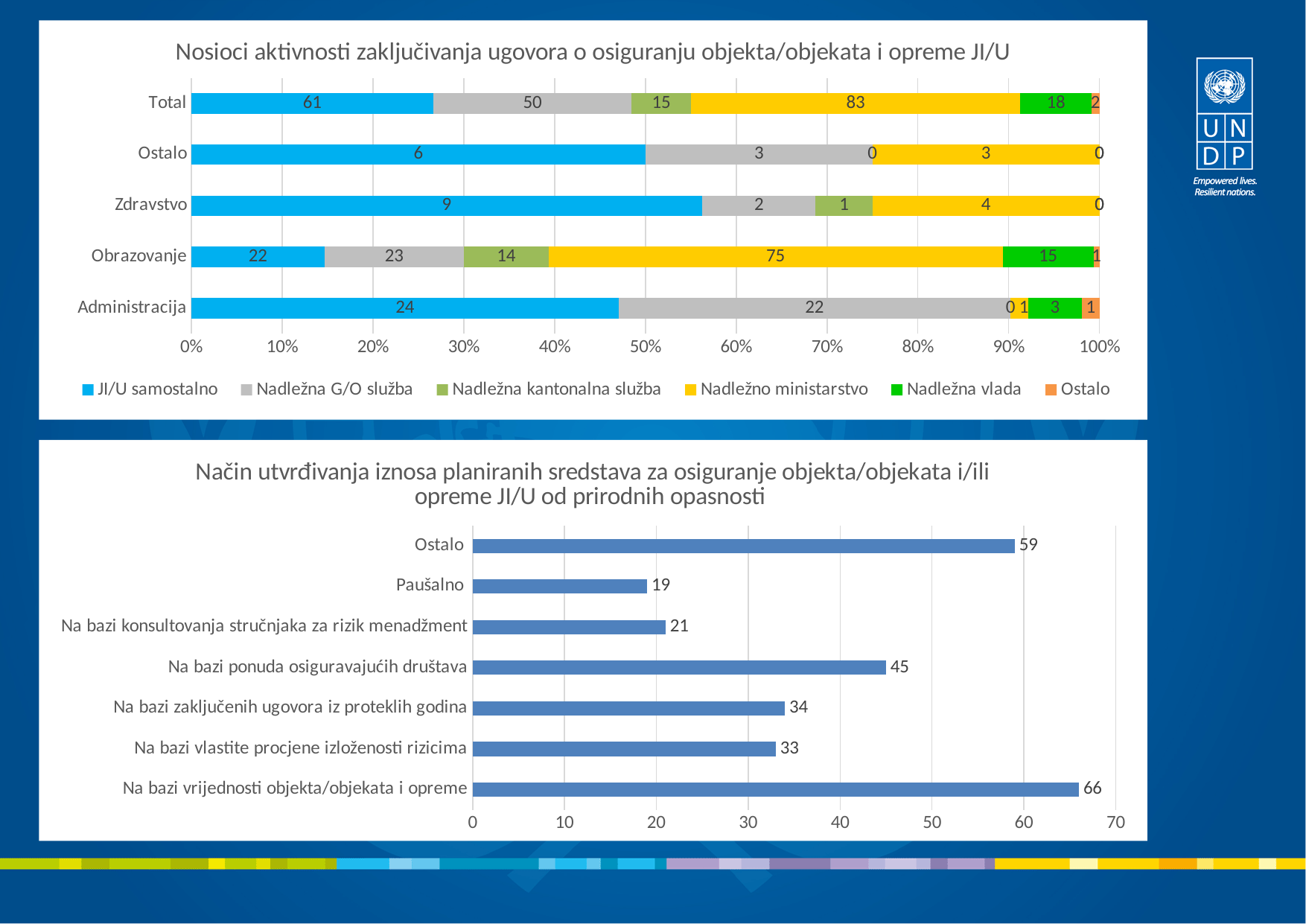
In the top chart, how many series does the legend list? 6 In the bottom chart, how many categories are shown? 7 In the top chart, what is the difference between Nadležno ministarstvo and JI/U samostalno in the Total bar? 22 In the bottom chart, which category has the lowest value? Paušalno In the bottom chart, what is the difference between Ostalo and Paušalno? 40 In the top chart, what is the sum of the labelled values in the Obrazovanje bar? 150 In the bottom chart, what is the value for Na bazi ponuda osiguravajućih društava? 45 In the bottom chart, which category has the highest value? Na bazi vrijednosti objekta/objekata i opreme In the top chart, what is the value for JI/U samostalno in the Total bar? 61 What kind of chart is the bottom chart? Bar chart In the top chart, what is the value for Nadležno ministarstvo in the Obrazovanje bar? 75 In the top chart, what is the value for Nadležna G/O služba in the Administracija bar? 22